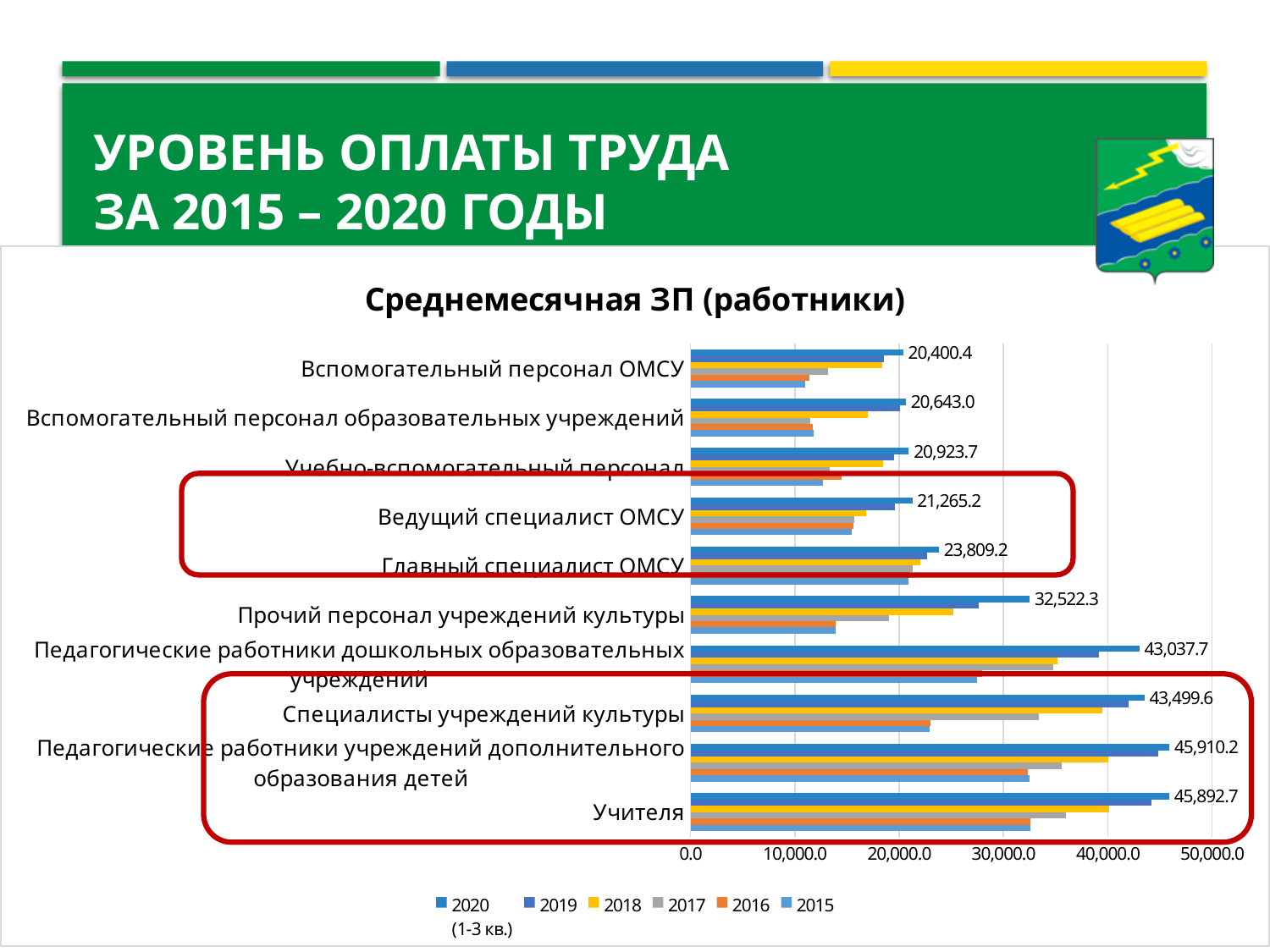
What is the title of the chart? Среднемесячная ЗП (работники) Which category has the highest 2020 (1-3 кв.) value? Педагогические работники учреждений дополнительного образования детей What is the 2020 (1-3 кв.) value for Главный специалист ОМСУ? 23,809.2 How many series does the legend list? 6 Which category has the lowest 2020 (1-3 кв.) value? Вспомогательный персонал ОМСУ What is the difference between the 2020 (1-3 кв.) values for Специалисты учреждений культуры and Педагогические работники дошкольных образовательных учреждений? 461.9 Which has the larger 2020 (1-3 кв.) value: Главный специалист ОМСУ or Ведущий специалист ОМСУ? Главный специалист ОМСУ How many job categories are shown on the chart? 10 What is the 2020 (1-3 кв.) value for Учителя? 45,892.7 What type of chart is shown on the slide? bar chart Is the 2016 value for Прочий персонал учреждений культуры greater or less than 20,000.0? less What is the 2020 (1-3 кв.) value for Прочий персонал учреждений культуры? 32,522.3